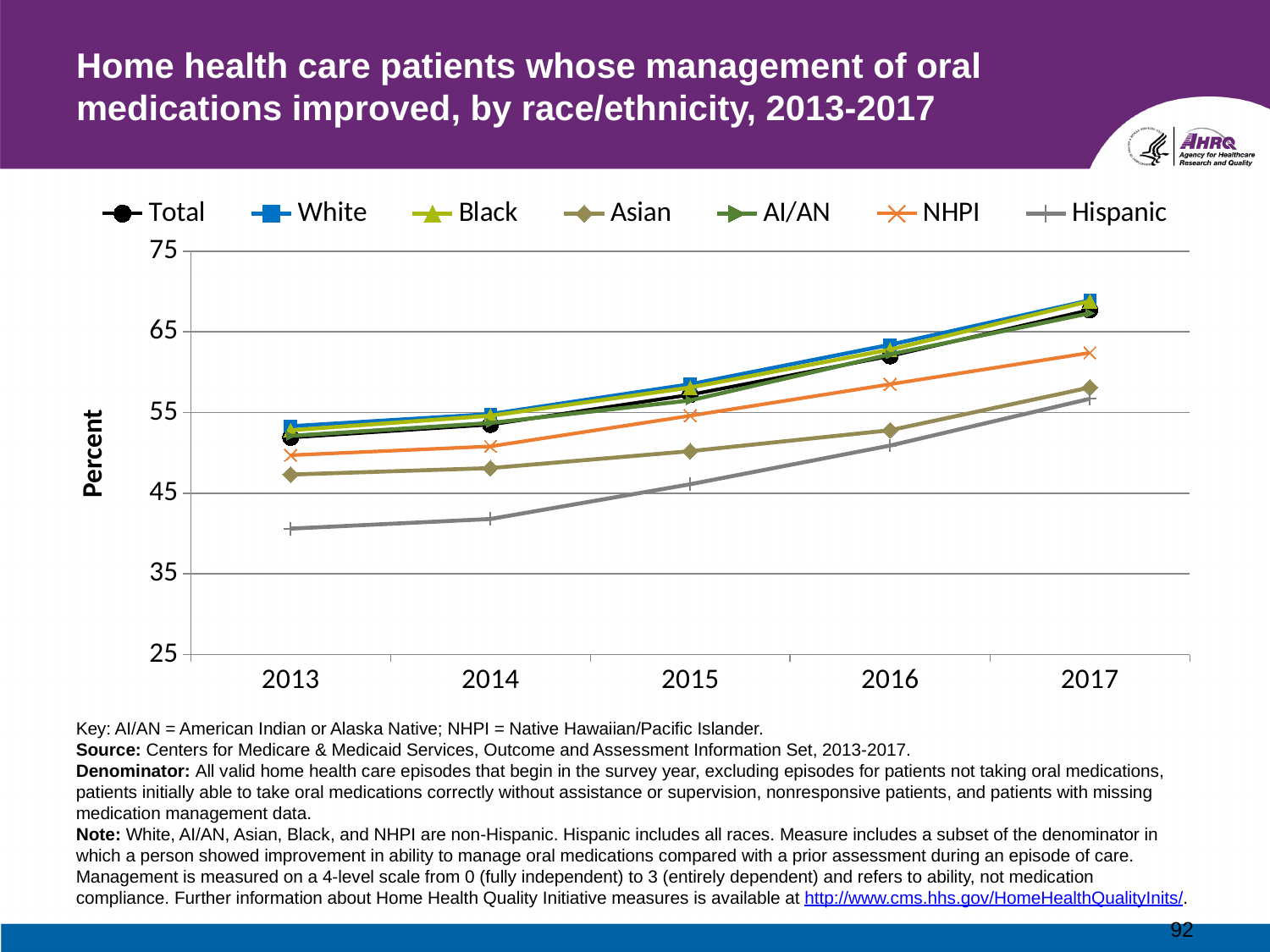
Is the value for Asian in 2013 greater or less than 45? greater Is the value for Total in 2013 greater or less than 55? less Does the Hispanic line rise or fall from 2013 to 2017? rise How many series does the legend list? 7 Is the value for White in 2017 greater or less than 65? greater What is the label of the y axis? Percent Which race/ethnicity group has the lowest value in 2013? Hispanic What kind of chart is shown on the slide? line chart Which is larger in 2016, the value for White or the value for Asian? White How many years are plotted along the x axis? 5